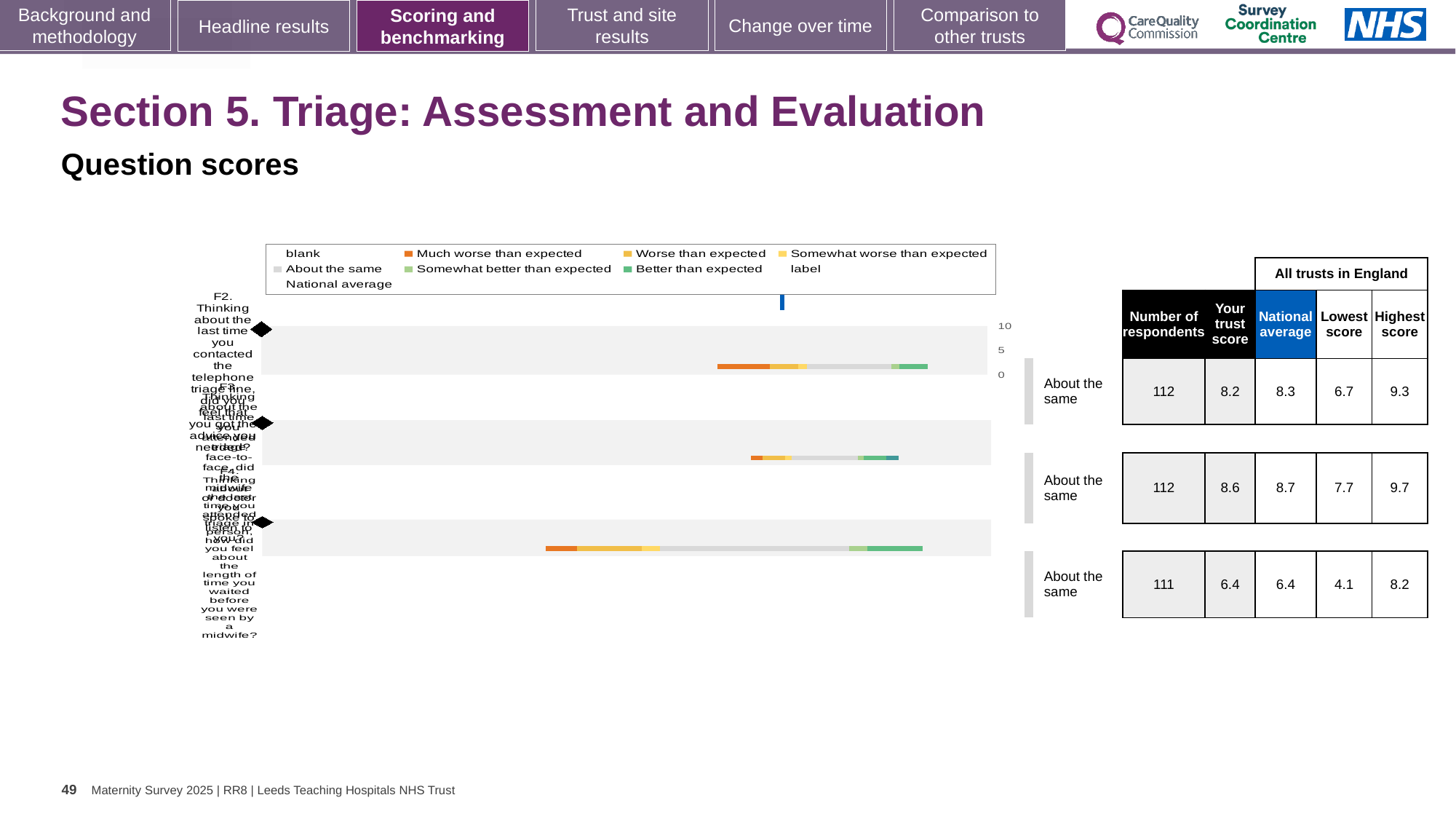
In the table next to the chart, what is the difference between the 'Highest score' and 'Lowest score' in the third row? 4.1 In the table next to the chart, what is the 'Your trust score' value in the first row? 8.2 In the table next to the chart, what is the 'Highest score' in the second row? 9.7 How many question categories (rows) are plotted on the chart? 3 In the table next to the chart, is the 'National average' in the first row larger or smaller than the 'Your trust score' in that row? larger What is the highest tick value shown on the chart's axis? 10 What benchmark label is shown beside each of the three rows of the chart? About the same In the table next to the chart, what is the 'Number of respondents' in the third row? 111 In the table next to the chart, which row has the lowest 'Your trust score'? the third row (6.4) Which colour does the chart legend use for 'Much worse than expected'? orange What kind of chart is shown on the slide? bar chart